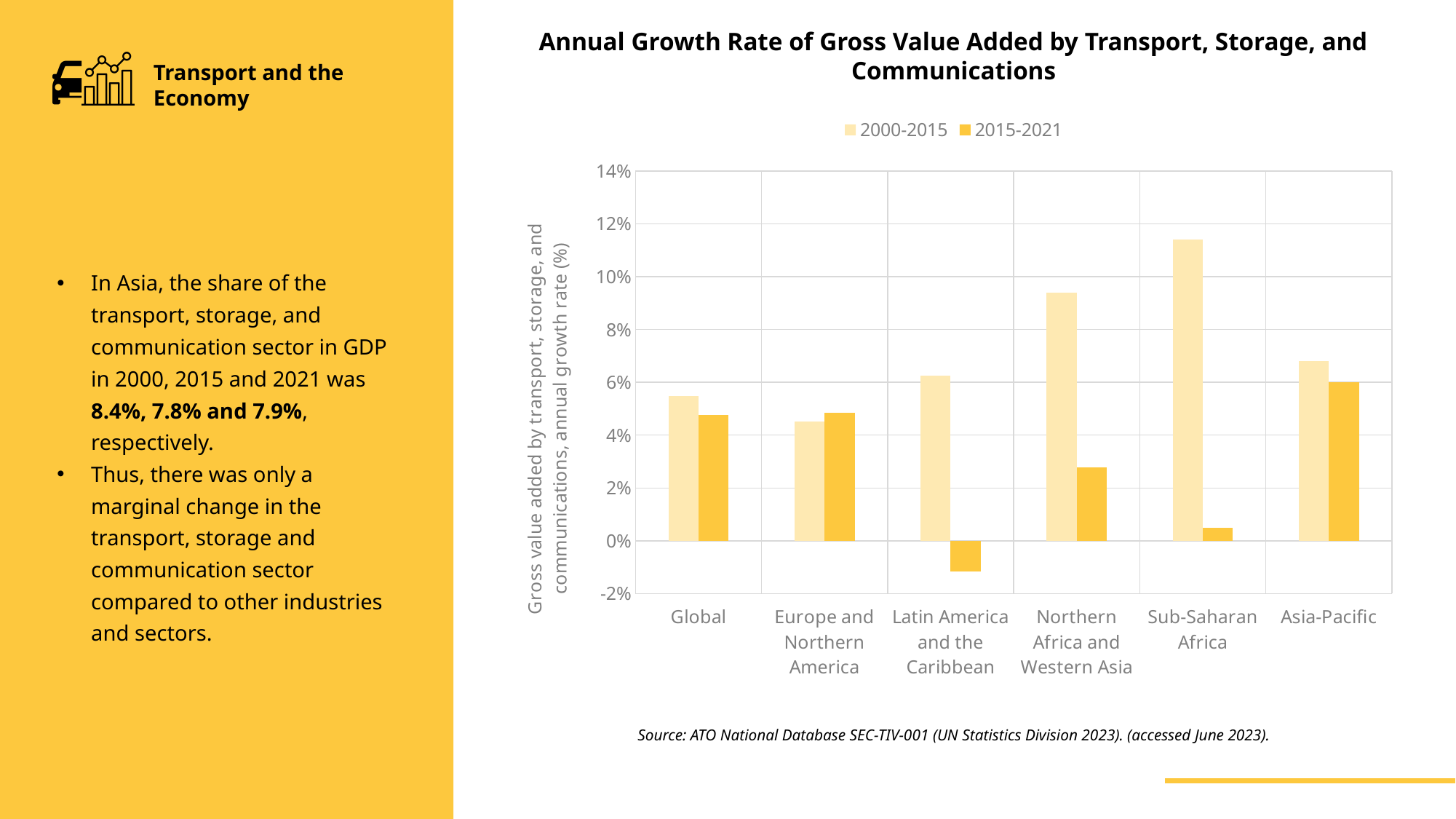
How many regions (categories) are shown on the x axis? 6 What is the label on the vertical axis of the chart? Gross value added by transport, storage, and communications, annual growth rate (%) What kind of chart is shown on the slide? Bar chart Is the 2015-2021 value for Latin America and the Caribbean greater or less than 0%? less How many series does the legend list? 2 Is the 2015-2021 value for Northern Africa and Western Asia greater or less than 4%? less Which region has the highest value for 2000-2015? Sub-Saharan Africa Is the 2000-2015 value for Sub-Saharan Africa greater or less than 10%? greater For Global, which period has the larger value, 2000-2015 or 2015-2021? 2000-2015 Which region has the lowest value for 2015-2021? Latin America and the Caribbean Which region has the highest value for 2015-2021? Asia-Pacific For 2000-2015, which is larger, Asia-Pacific or Sub-Saharan Africa? Sub-Saharan Africa